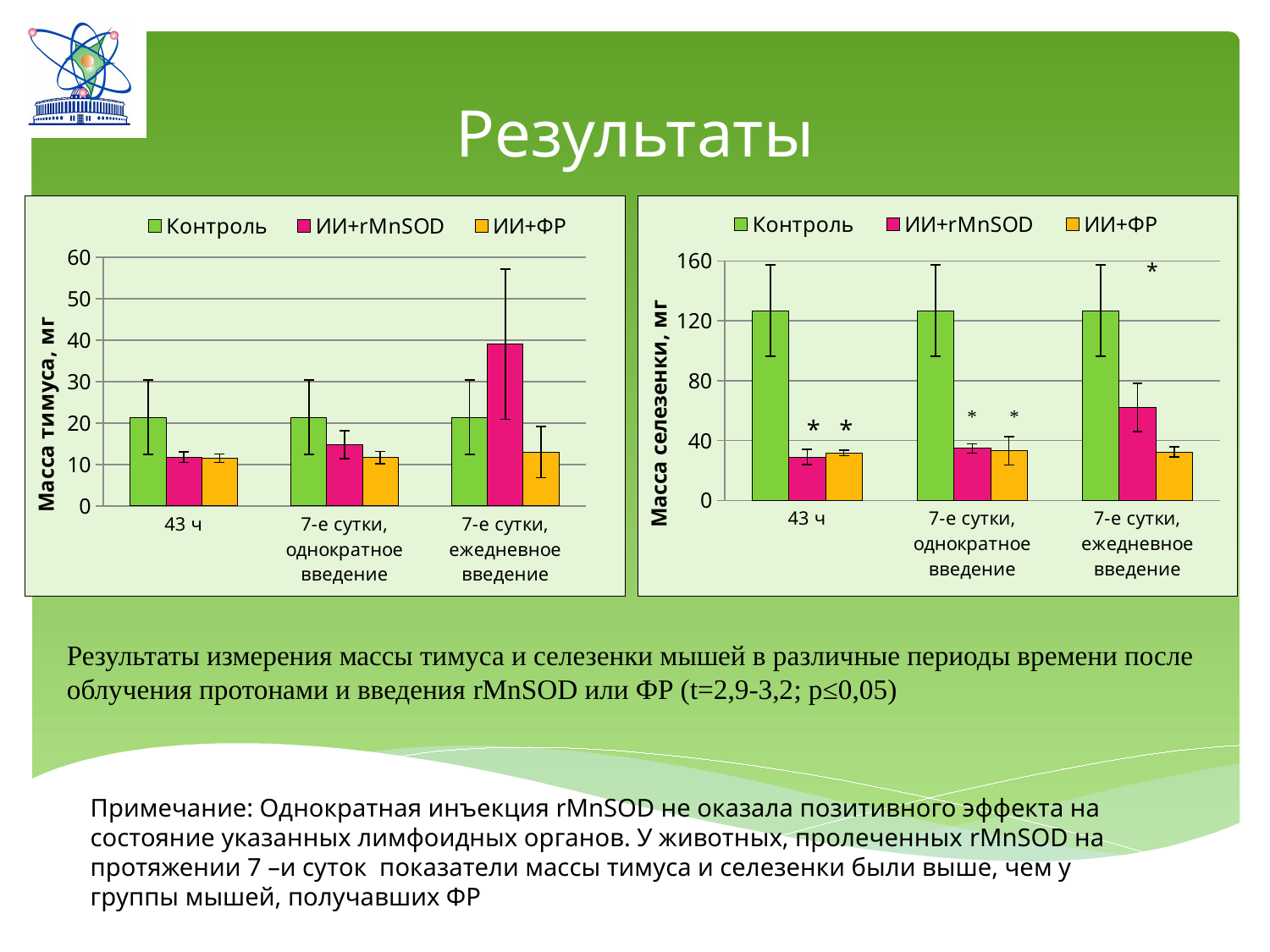
In the right chart (Масса селезенки, мг), is the value for Контроль at '43 ч' greater or less than 80? greater What kind of chart is the left chart (Масса тимуса, мг)? bar chart In the left chart (Масса тимуса, мг), is the value for Контроль at '43 ч' greater or less than 30? less In the right chart (Масса селезенки, мг), is the value for ИИ+rMnSOD at '7-е сутки, ежедневное введение' greater or less than 40? greater In the right chart (Масса селезенки, мг), do the values for ИИ+rMnSOD rise or fall from '43 ч' to '7-е сутки, ежедневное введение'? rise What is the y-axis label of the left chart? Масса тимуса, мг In the right chart (Масса селезенки, мг), which is larger at '43 ч': Контроль or ИИ+rMnSOD? Контроль In the left chart (Масса тимуса, мг), which series has the highest value at '7-е сутки, ежедневное введение'? ИИ+rMnSOD How many categories are shown on the x axis of the left chart (Масса тимуса, мг)? 3 How many series does the legend of the right chart (Масса селезенки, мг) list? 3